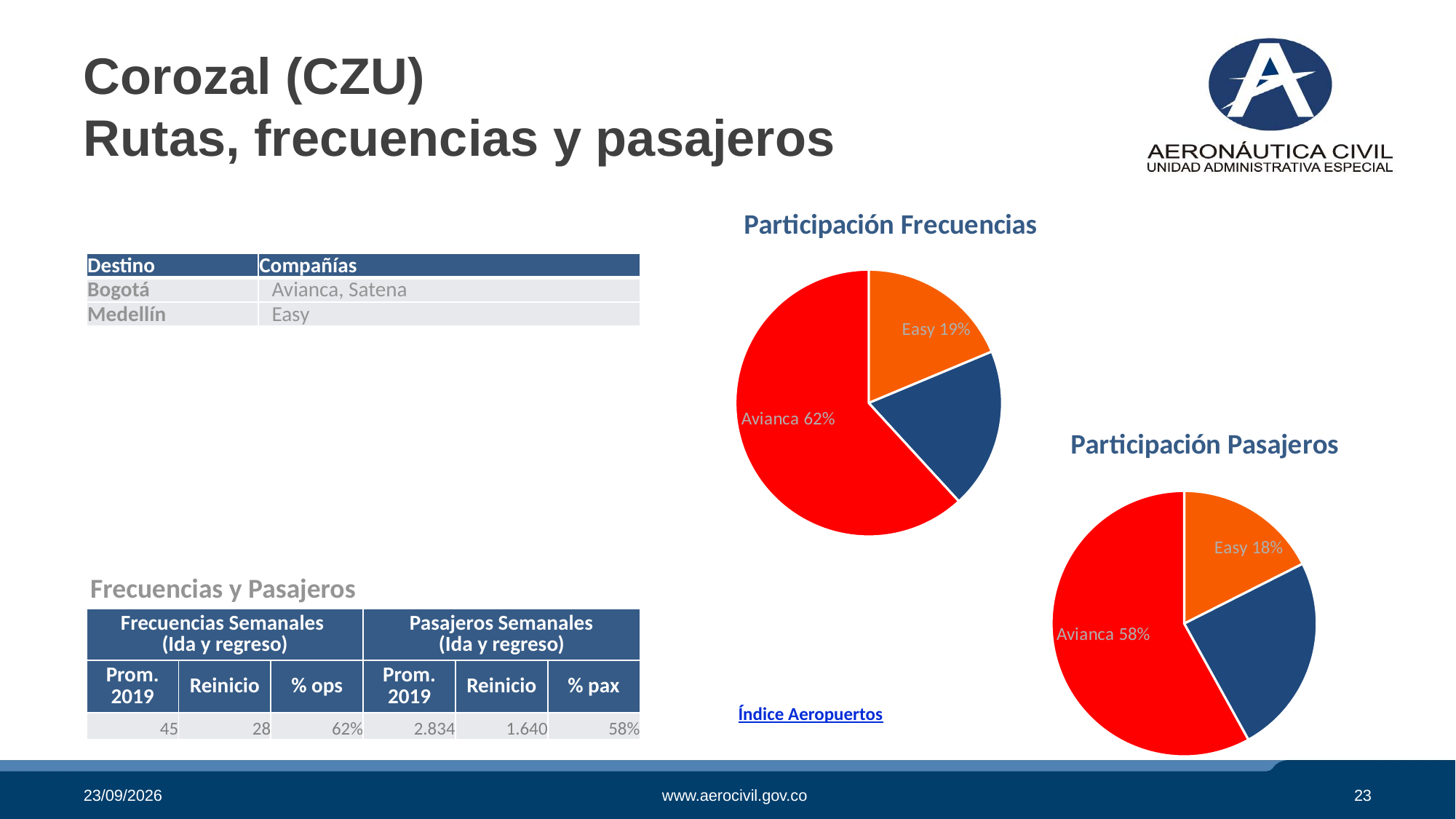
In the 'Participación Pasajeros' chart, what share does Avianca have? 58% What is the title of the pie chart on the right side of the slide, below the first one? Participación Pasajeros In the 'Participación Frecuencias' chart, which labelled slice is the largest? Avianca In the 'Participación Pasajeros' chart, which is larger, Avianca's share or Easy's share? Avianca In the 'Participación Frecuencias' chart, what is the difference in percentage points between Avianca's share and Easy's share? 43 percentage points In the 'Participación Frecuencias' chart, what share does Easy have? 19% How many slices does the 'Participación Pasajeros' pie chart have? 3 In the 'Participación Pasajeros' chart, what is the difference in percentage points between Avianca's share and Easy's share? 40 percentage points In the 'Participación Pasajeros' chart, which labelled slice is the largest? Avianca In the 'Participación Frecuencias' chart, what share does Avianca have? 62% What kind of chart is 'Participación Frecuencias'? Pie chart In the 'Participación Pasajeros' chart, what share does Easy have? 18%